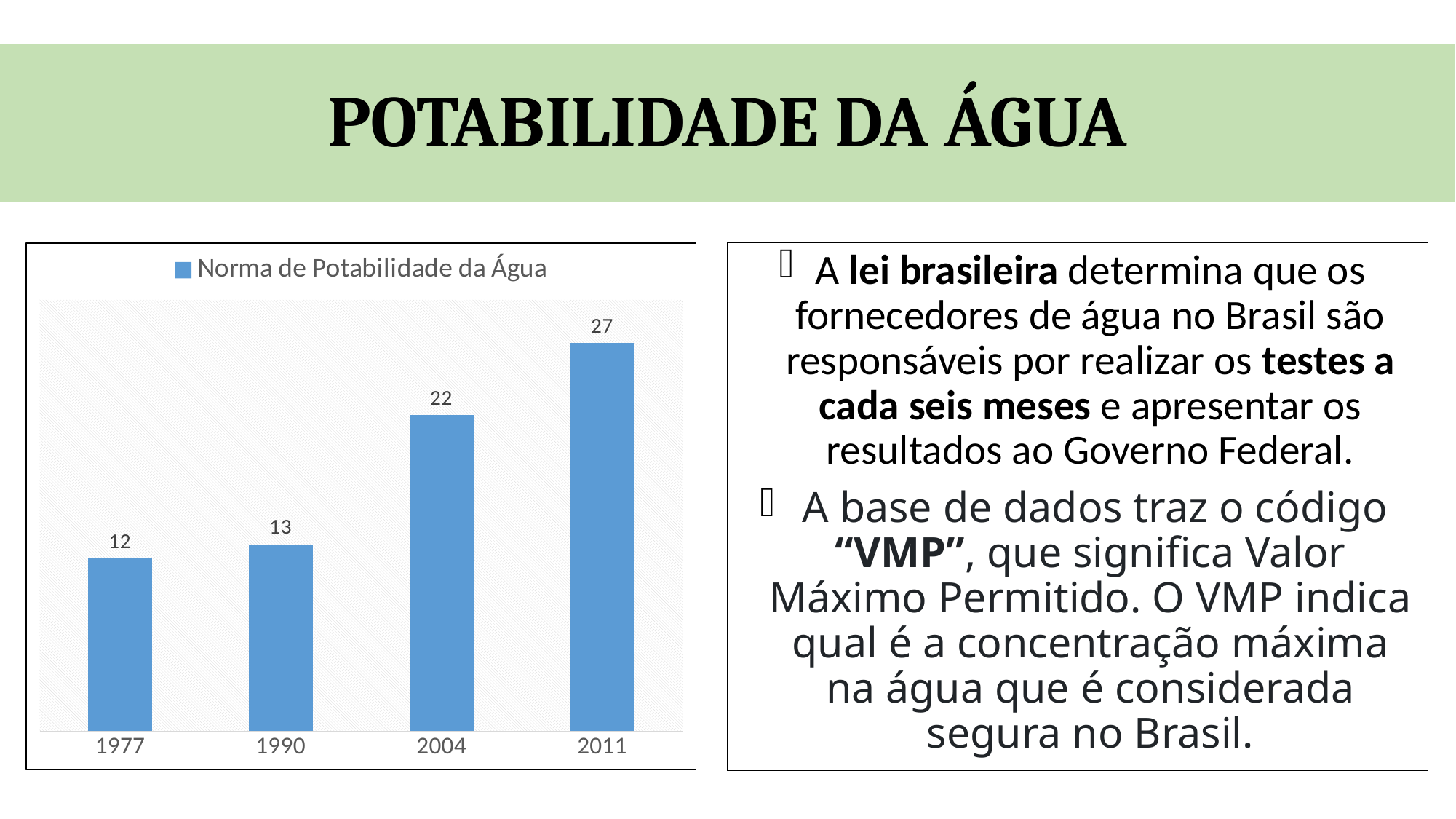
What is the value for 2011? 27 What is the difference between the values for 2004 and 1990? 9 What kind of chart is shown on the slide? Bar chart What is the value for 2004? 22 Do the values rise or fall from 1977 to 2011? Rise Which year has the highest value? 2011 What is the difference between the values for 2011 and 1977? 15 Which is larger, the value for 2004 or the value for 1990? 2004 What is the value for 1990? 13 How many years are shown on the x axis? 4 Which year has the lowest value? 1977 What is the value for 1977? 12